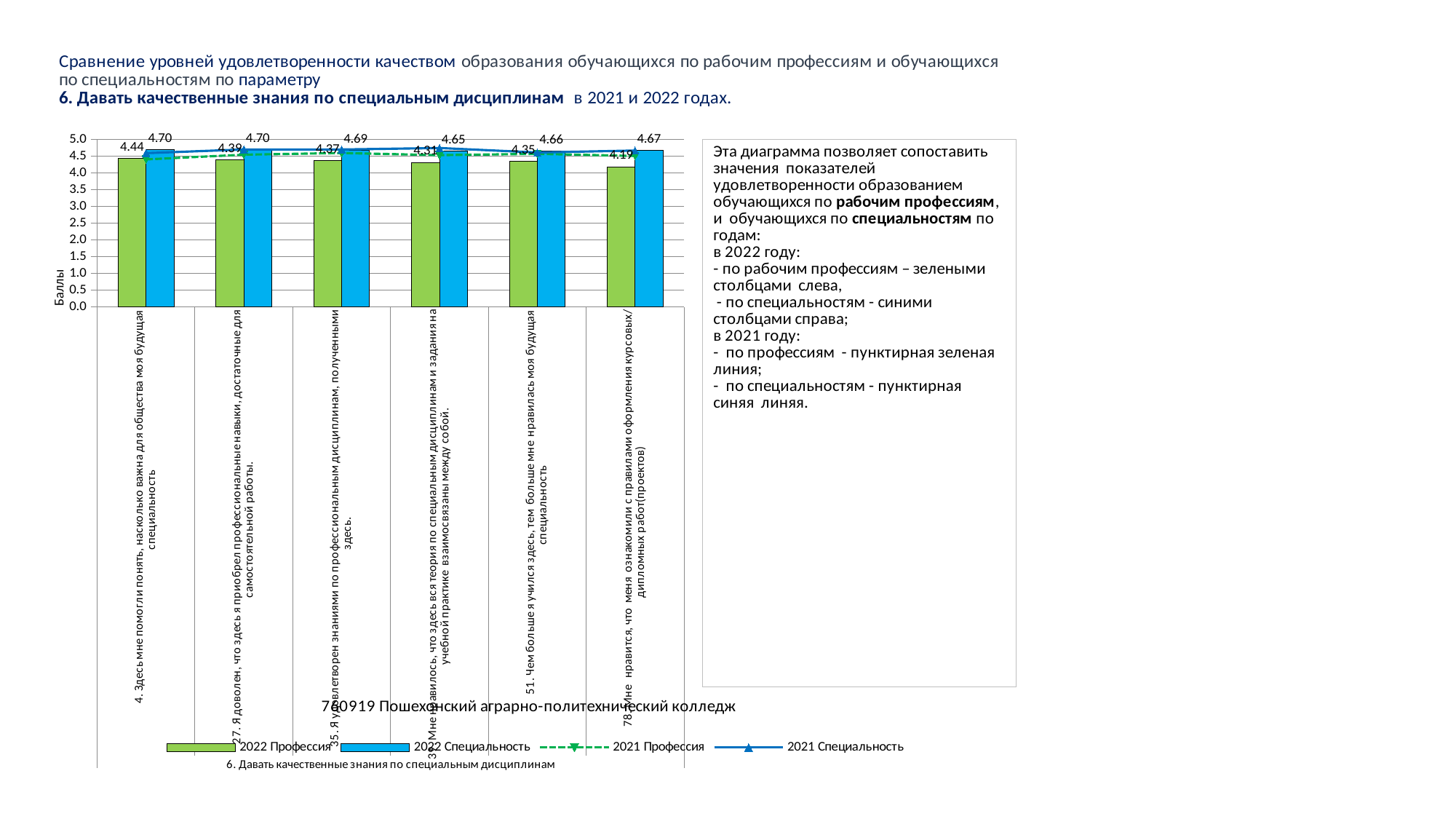
What is the 2022 Профессия value for statement 4 (Здесь мне помогли понять, насколько важна для общества моя будущая специальность)? 4.44 What is the 2022 Специальность value for statement 78 (Мне нравится, что меня ознакомили с правилами оформления курсовых/дипломных работ)? 4.67 How many series does the chart legend list? 4 For statement 78, what is the difference between the 2022 Специальность and 2022 Профессия values? 0.48 Is the 2022 Профессия value for statement 27 greater or less than 4.0? greater What kind of chart is shown on the slide? A bar chart combined with line series For statement 51, which is larger: the 2022 Профессия value or the 2022 Специальность value? 2022 Специальность (4.66) How many statements (categories) are shown on the x axis of the chart? 6 What is the title of the vertical axis of the chart? Баллы What is the 2022 Специальность value for the statement 'Мне нравилось, что здесь вся теория по специальным дисциплинам и задания на учебной практике взаимосвязаны между собой'? 4.65 Which statement has the lowest 2022 Профессия value? Statement 78 (4.19) Which statement has the highest 2022 Профессия value? Statement 4 (4.44)